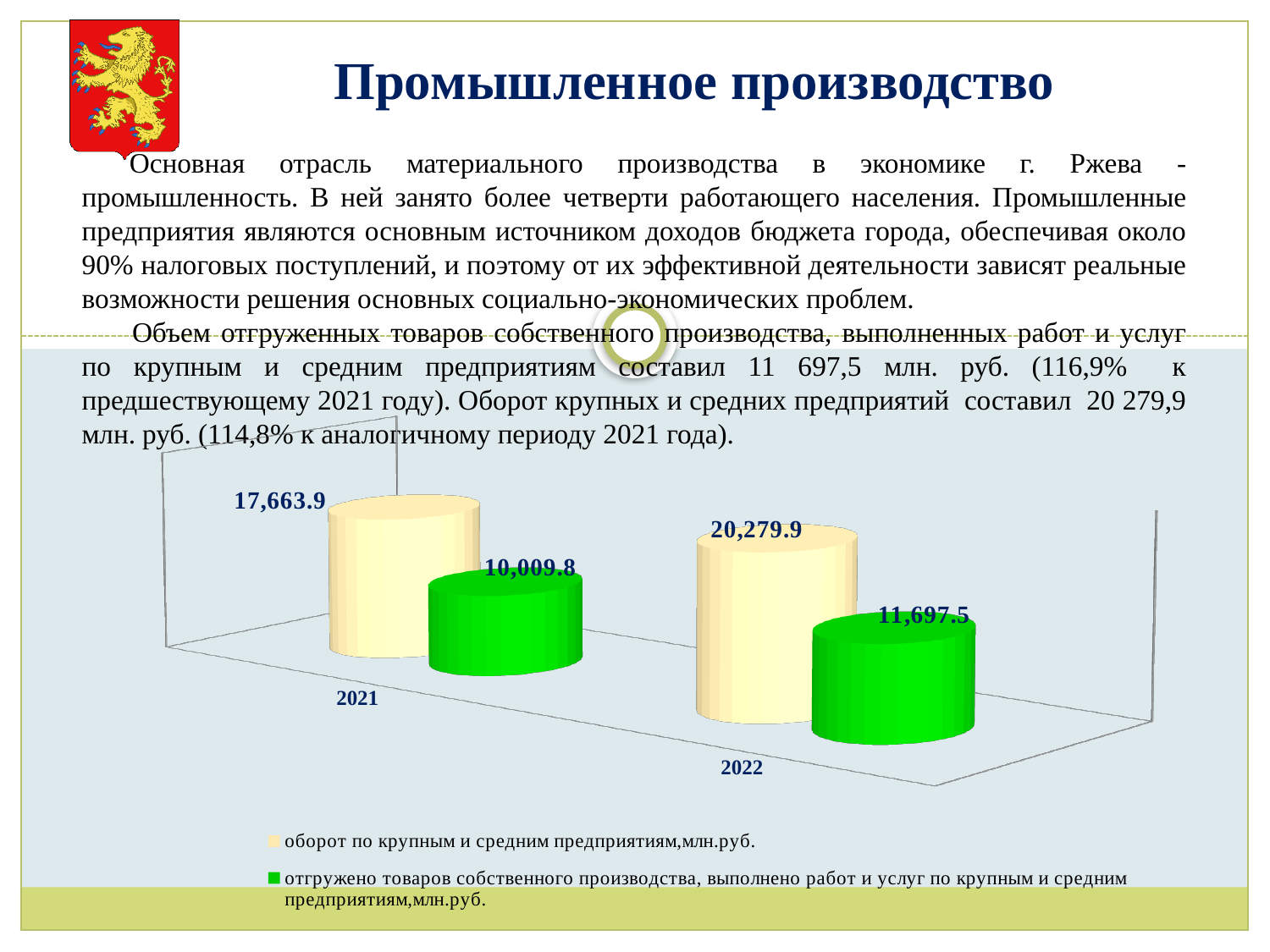
What is the value of отгружено товаров собственного производства for 2021? 10,009.8 What is the value of отгружено товаров собственного производства for 2022? 11,697.5 What is the value of оборот по крупным и средним предприятиям for 2021? 17,663.9 How many years are shown on the chart? 2 Which year has the higher value for оборот по крупным и средним предприятиям? 2022 How many series does the legend list? 2 What kind of chart is shown on the slide? bar chart Which year has the lower value for отгружено товаров собственного производства? 2021 What is the difference between оборот and отгружено товаров in 2022? 8,582.4 What is the value of оборот по крупным и средним предприятиям for 2022? 20,279.9 Which is larger in 2021: оборот по крупным и средним предприятиям or отгружено товаров собственного производства? оборот по крупным и средним предприятиям By how much did оборот по крупным и средним предприятиям increase from 2021 to 2022? 2,616.0